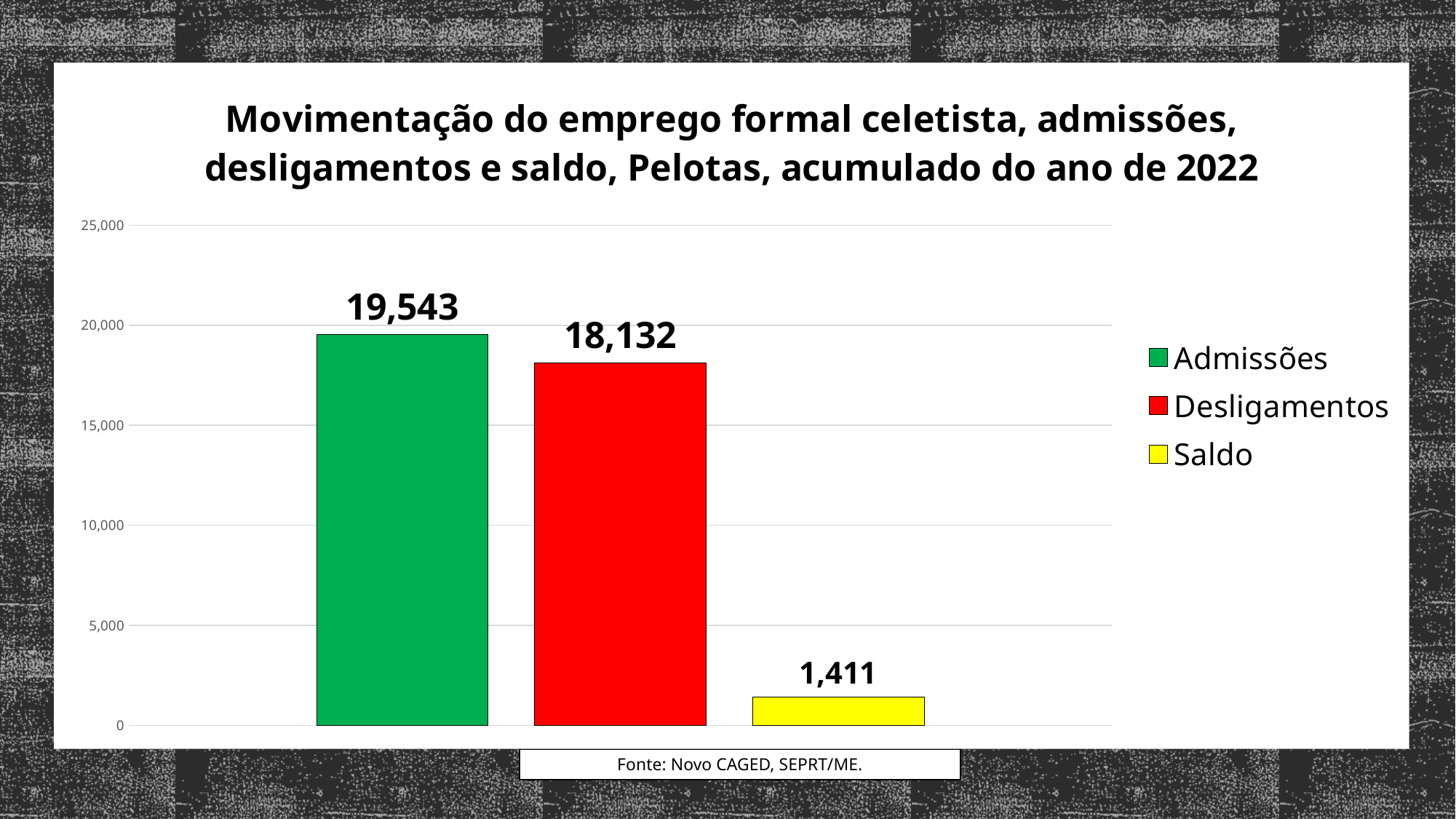
Which series has the lowest value? Saldo What is the value for Saldo? 1,411 How many bars are plotted on the chart? 3 What colour is the bar for Saldo? yellow What is the difference between Admissões and Desligamentos? 1,411 What is the value for Admissões? 19,543 What kind of chart is shown on the slide? bar chart Which is larger, Admissões or Desligamentos? Admissões Is the value for Desligamentos greater or less than 20,000? less What is the value for Desligamentos? 18,132 How many series does the legend list? 3 Which series has the highest value? Admissões